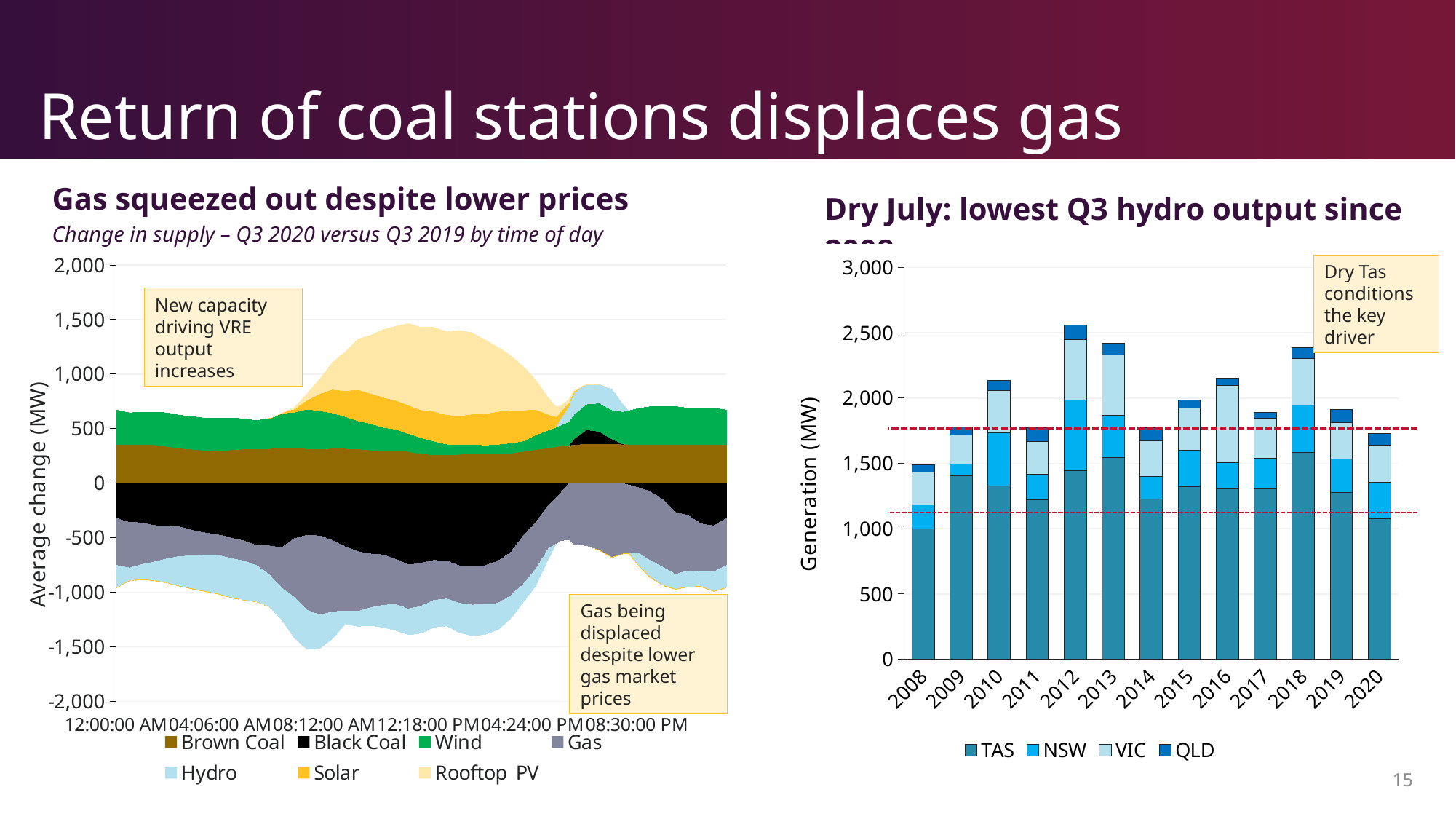
What kind of chart is the right-hand chart, 'Dry July: lowest Q3 hydro output since 2008'? Bar chart In the right-hand chart, is the total generation for 2012 greater or less than 2,000? greater How many series does the legend of the left-hand chart list? 7 In the right-hand chart, is the TAS value for 2008 greater or less than 1,500? less What kind of chart is the left-hand chart, 'Gas squeezed out despite lower prices'? Area chart What is the y-axis label of the right-hand chart? Generation (MW) In the right-hand chart, which year has the larger total generation, 2010 or 2011? 2010 How many series does the legend of the right-hand chart list? 4 In the right-hand chart, is the total generation for 2020 greater or less than 2,000? less In the right-hand chart, which year has the lowest total generation? 2008 In the right-hand chart, which year has the highest total generation? 2012 How many years are shown on the x axis of the right-hand chart? 13